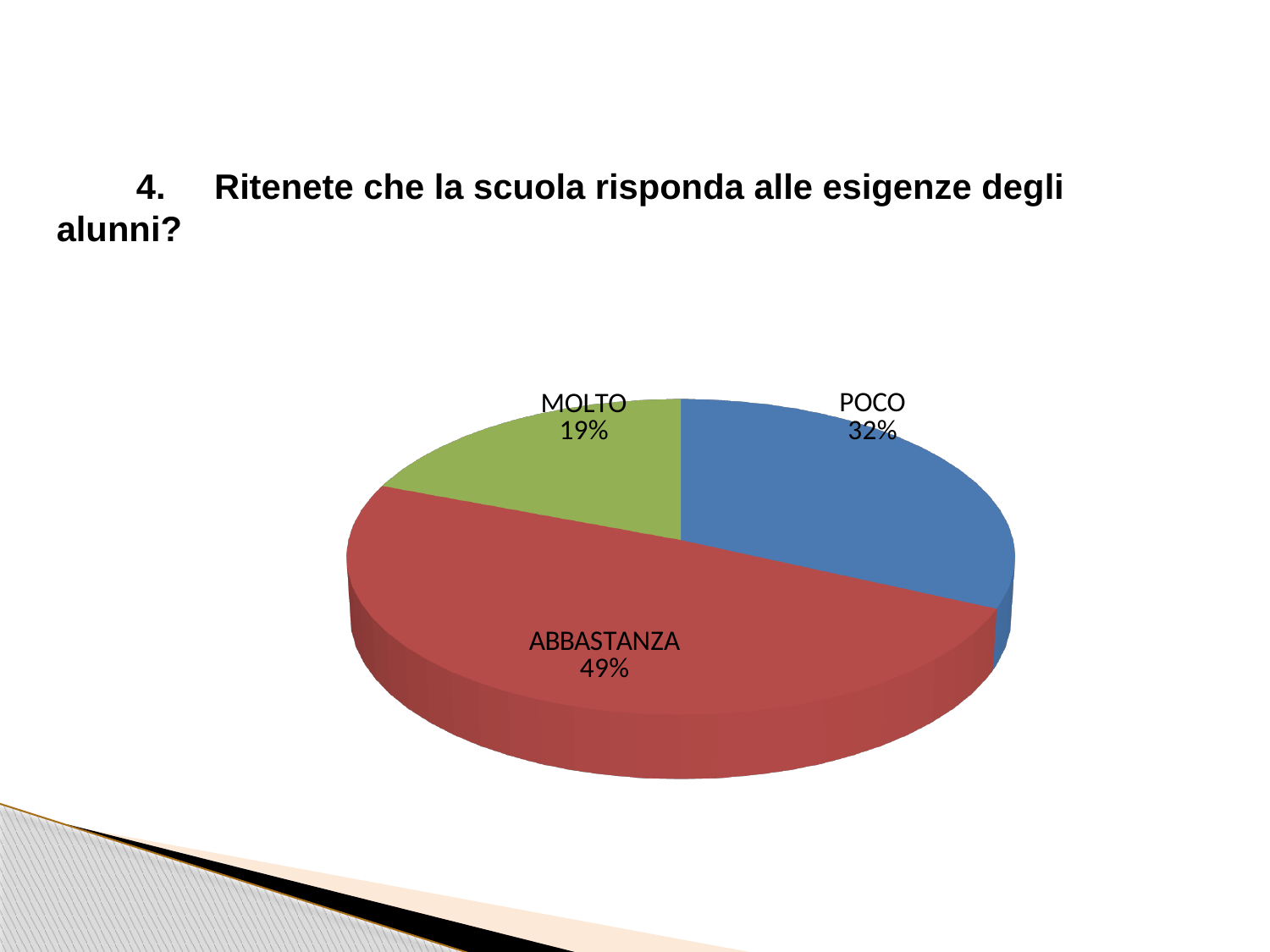
How many slices does the pie chart have? 3 What share of the pie does ABBASTANZA represent? 49% What colour is the ABBASTANZA slice? Red Which is larger, the share for POCO or the share for MOLTO? POCO What colour is the MOLTO slice? Green What is the difference in percentage points between POCO and MOLTO? 13 What share of the pie does MOLTO represent? 19% What is the difference in percentage points between ABBASTANZA and POCO? 17 What share of the pie does POCO represent? 32% Which category has the smallest slice of the pie? MOLTO What kind of chart is shown on the slide? Pie chart Which category has the largest slice of the pie? ABBASTANZA